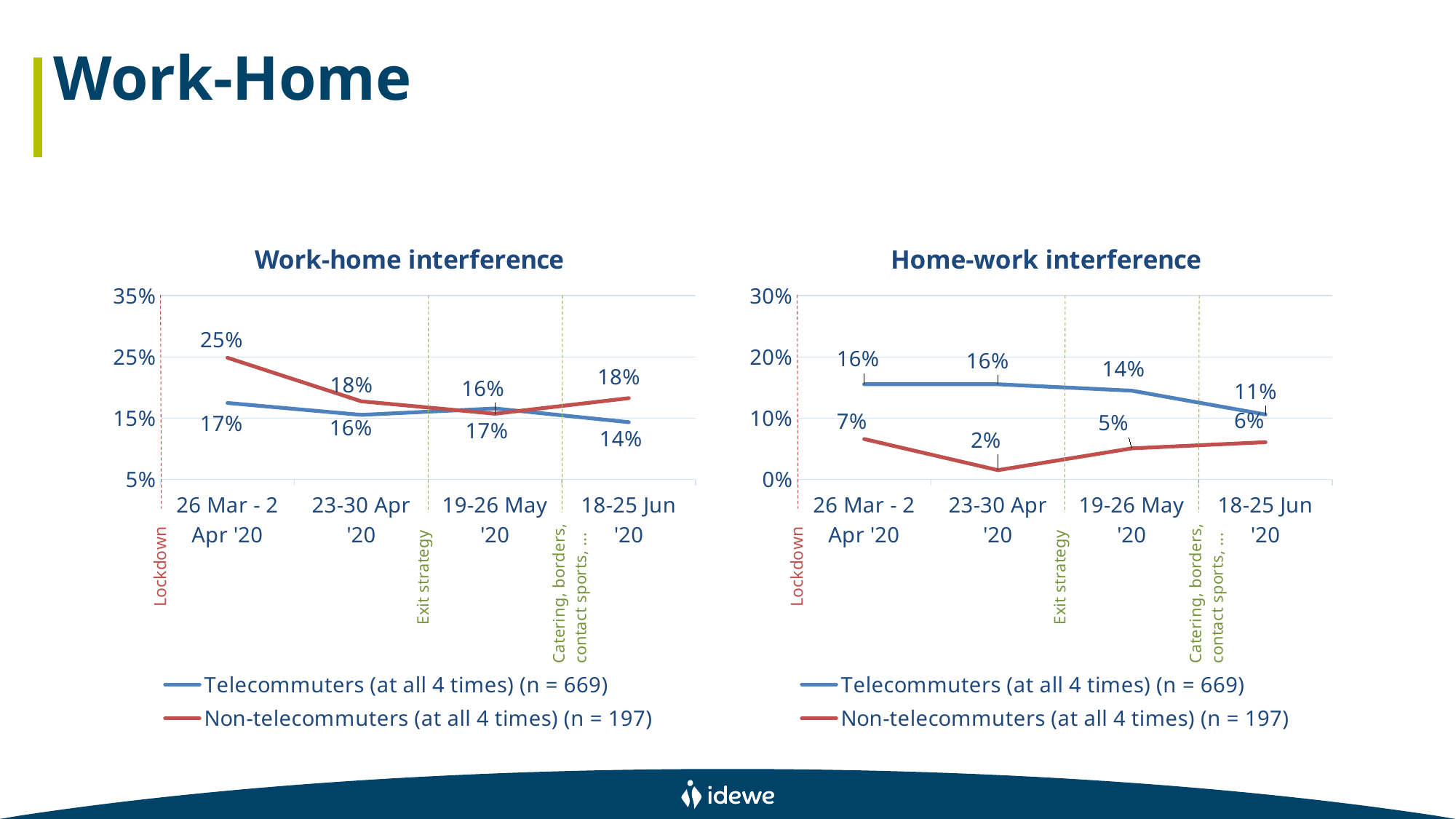
How many series does the legend of the 'Work-home interference' chart list? 2 In the 'Home-work interference' chart, what is the value for Telecommuters at 19-26 May '20? 14% In the 'Work-home interference' chart, at which period is the Non-telecommuters value highest? 26 Mar - 2 Apr '20 What kind of chart is the 'Work-home interference' chart? Line chart In the 'Home-work interference' chart, at which period is the Non-telecommuters value lowest? 23-30 Apr '20 In the 'Work-home interference' chart, what is the value for Telecommuters at 18-25 Jun '20? 14% In the 'Home-work interference' chart, what is the value for Non-telecommuters at 23-30 Apr '20? 2% How many time periods are shown on the x axis of the 'Home-work interference' chart? 4 In the 'Work-home interference' chart, how much higher is the Non-telecommuters value than the Telecommuters value at 26 Mar - 2 Apr '20? 8 percentage points In the 'Work-home interference' chart, what is the value for Non-telecommuters at 26 Mar - 2 Apr '20? 25% In the 'Home-work interference' chart, which series has the higher value at 26 Mar - 2 Apr '20? Telecommuters (at all 4 times) (n = 669) In the 'Home-work interference' chart, does the Telecommuters line rise or fall from 26 Mar - 2 Apr '20 to 18-25 Jun '20? Fall